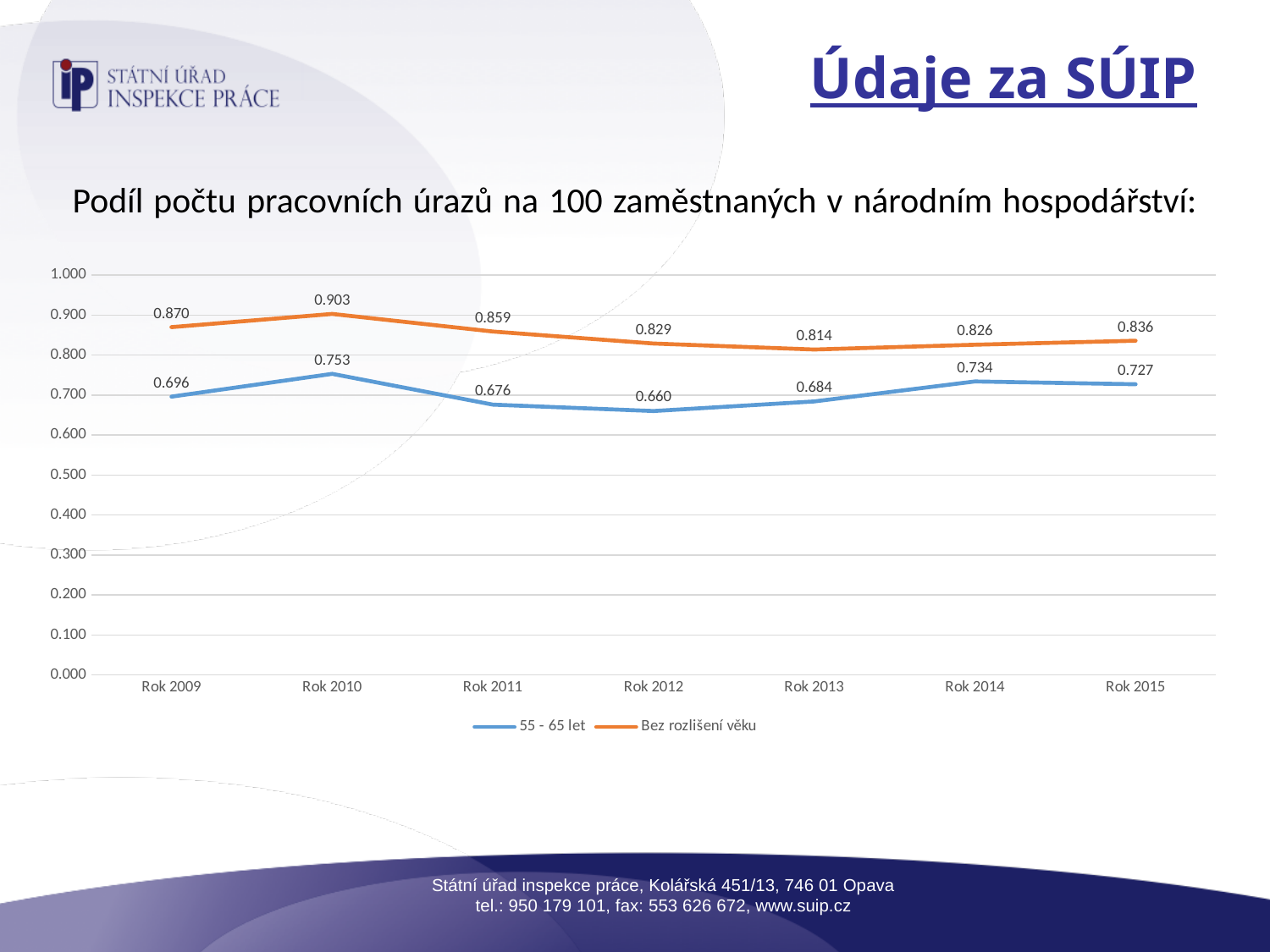
How many years are shown on the x axis? 7 In which year is the "Bez rozlišení věku" series highest? Rok 2010 What is the value for "55 - 65 let" in Rok 2015? 0.727 How many series does the legend list? 2 Does the "Bez rozlišení věku" series rise or fall from Rok 2010 to Rok 2013? Fall What kind of chart is shown on the slide? Line chart Which series has the larger value in Rok 2013, "55 - 65 let" or "Bez rozlišení věku"? Bez rozlišení věku What is the difference between "Bez rozlišení věku" and "55 - 65 let" in Rok 2009? 0.174 What is the value for "55 - 65 let" in Rok 2012? 0.660 Is the value for "55 - 65 let" in Rok 2014 greater or less than 0.700? greater What is the value for "Bez rozlišení věku" in Rok 2010? 0.903 In which year is the "55 - 65 let" series lowest? Rok 2012